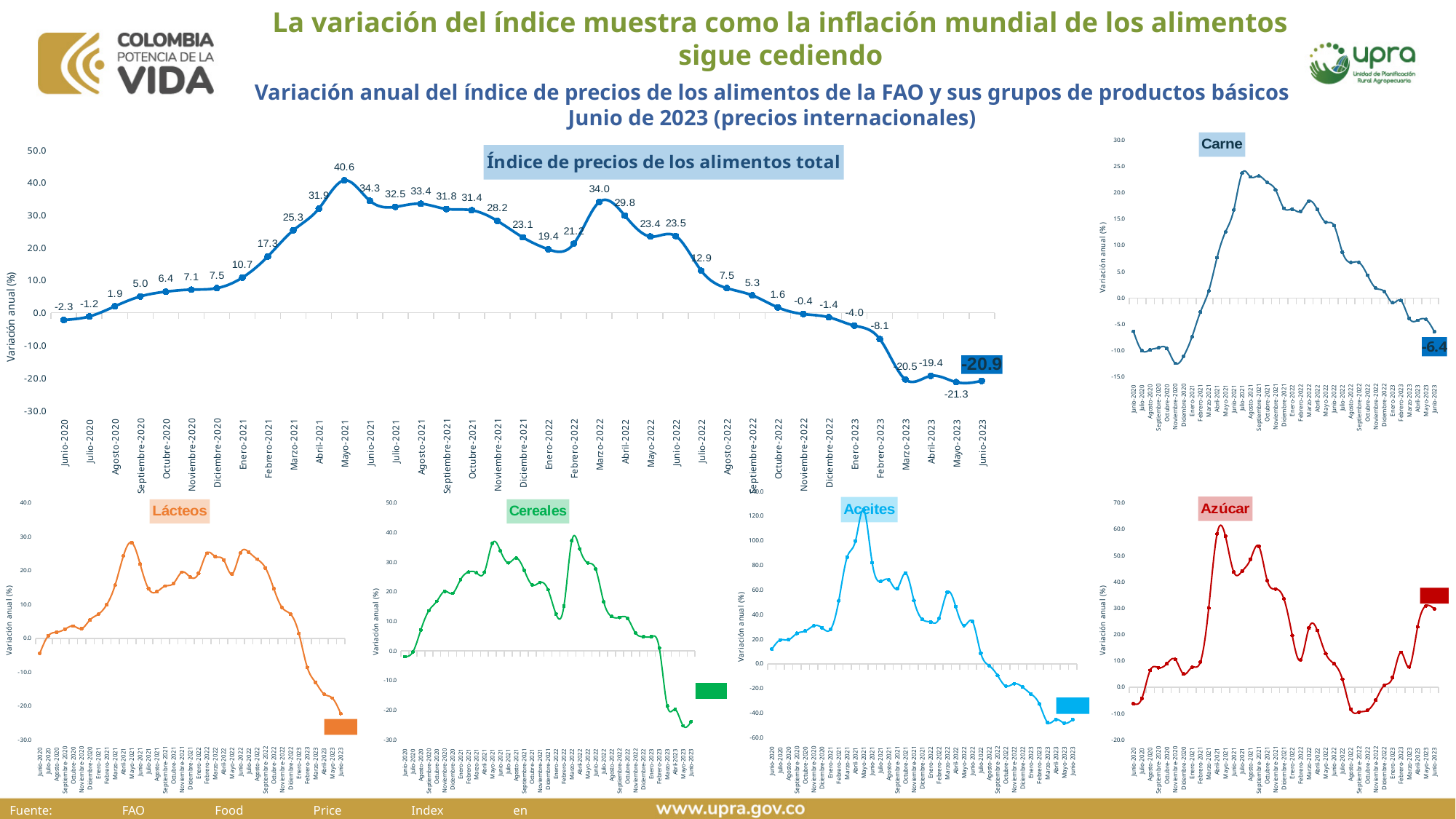
In the 'Índice de precios de los alimentos total' chart, what is the value for Junio-2023? -20.9 In the 'Carne' chart, is the peak value in 2021 greater or less than 20.0? greater In the 'Índice de precios de los alimentos total' chart, which month has the lowest value? Mayo-2023 What type of chart is the 'Índice de precios de los alimentos total' chart? Line chart In the 'Carne' chart, what is the value shown for Junio-2023? -6.4 In the 'Índice de precios de los alimentos total' chart, what is the value for Mayo-2021? 40.6 In the 'Índice de precios de los alimentos total' chart, what is the value for Marzo-2022? 34.0 In the 'Índice de precios de los alimentos total' chart, do the values rise or fall from Junio-2022 to Junio-2023? Fall In the 'Índice de precios de los alimentos total' chart, how many monthly data points are plotted? 37 In the 'Índice de precios de los alimentos total' chart, which is larger, the value for Abril-2021 or the value for Octubre-2021? Abril-2021 In the 'Índice de precios de los alimentos total' chart, which month has the highest value? Mayo-2021 In the 'Índice de precios de los alimentos total' chart, what is the difference between the values for Mayo-2021 and Junio-2021? 6.3